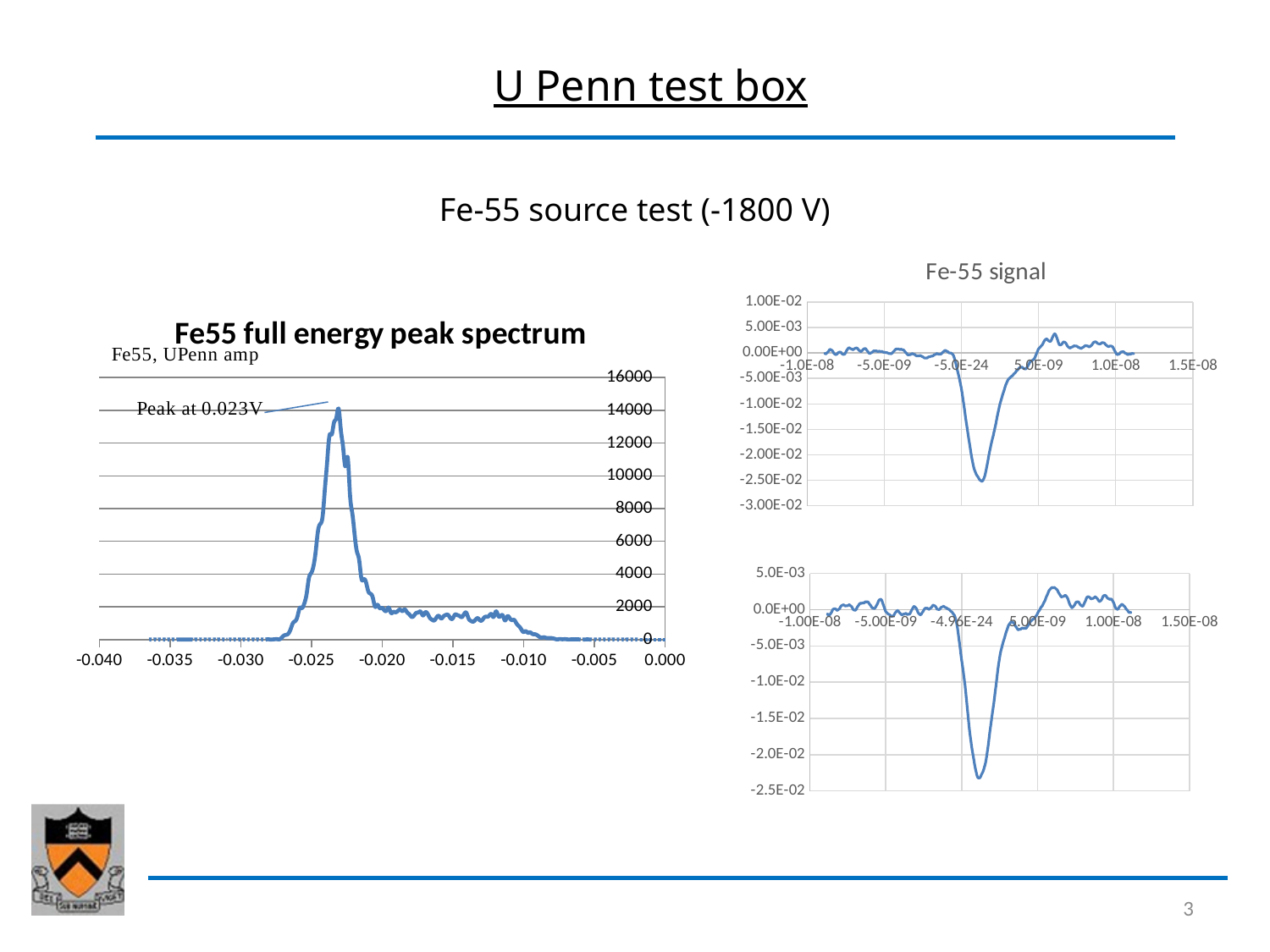
In the bottom-right chart, is the minimum value of the signal greater or less than -1.5E-02? less In the 'Fe-55 signal' chart, is the minimum value of the signal greater or less than -2.00E-02? less What does the annotation on the 'Fe55 full energy peak spectrum' chart say? Peak at 0.023V In the 'Fe-55 signal' chart, is the value at 1.0E-08 greater or less than 5.00E-03? less In the 'Fe55 full energy peak spectrum' chart, do the values rise or fall along the x axis from the peak near -0.023 to -0.010? fall What is the title of the top-right chart? Fe-55 signal What kind of chart is the 'Fe55 full energy peak spectrum' chart on the left? line chart How many charts are shown on the slide? 3 What kind of chart is the bottom-right chart? line chart